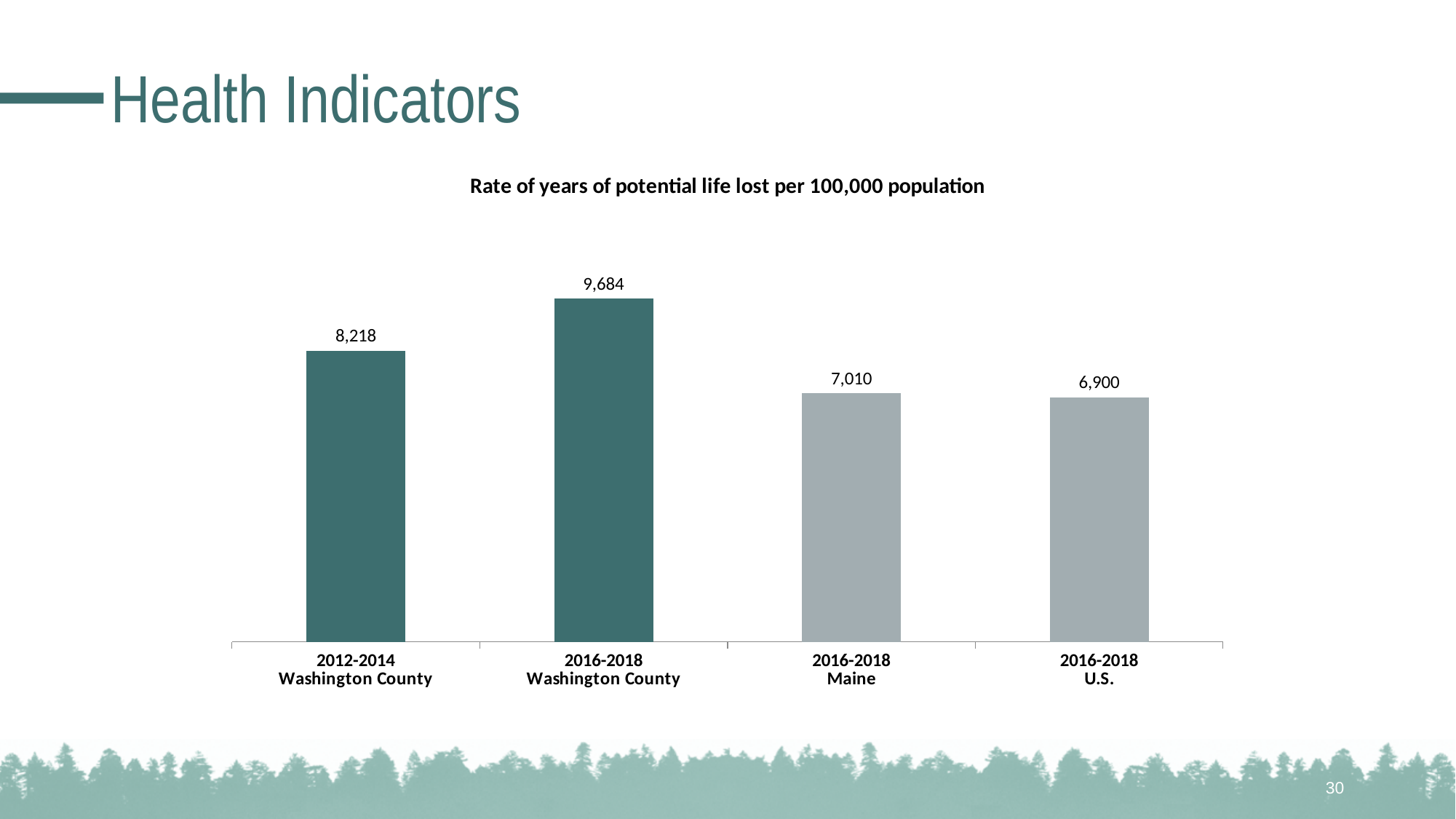
What is the rate of years of potential life lost per 100,000 population for Washington County in 2016-2018? 9,684 What is the rate of years of potential life lost per 100,000 population for Maine in 2016-2018? 7,010 What is the title of the chart? Rate of years of potential life lost per 100,000 population Which is larger, the 2016-2018 rate for Washington County or the 2016-2018 rate for Maine? 2016-2018 Washington County By how much did Washington County's rate of years of potential life lost increase from 2012-2014 to 2016-2018? 1,466 Which category has the lowest rate of years of potential life lost? 2016-2018 U.S. Which category has the highest rate of years of potential life lost? 2016-2018 Washington County What is the rate of years of potential life lost per 100,000 population for Washington County in 2012-2014? 8,218 What is the difference between the 2016-2018 rates for Maine and the U.S.? 110 How many bars are shown in the chart? 4 What is the rate of years of potential life lost per 100,000 population for the U.S. in 2016-2018? 6,900 What type of chart is shown on the slide? Bar chart